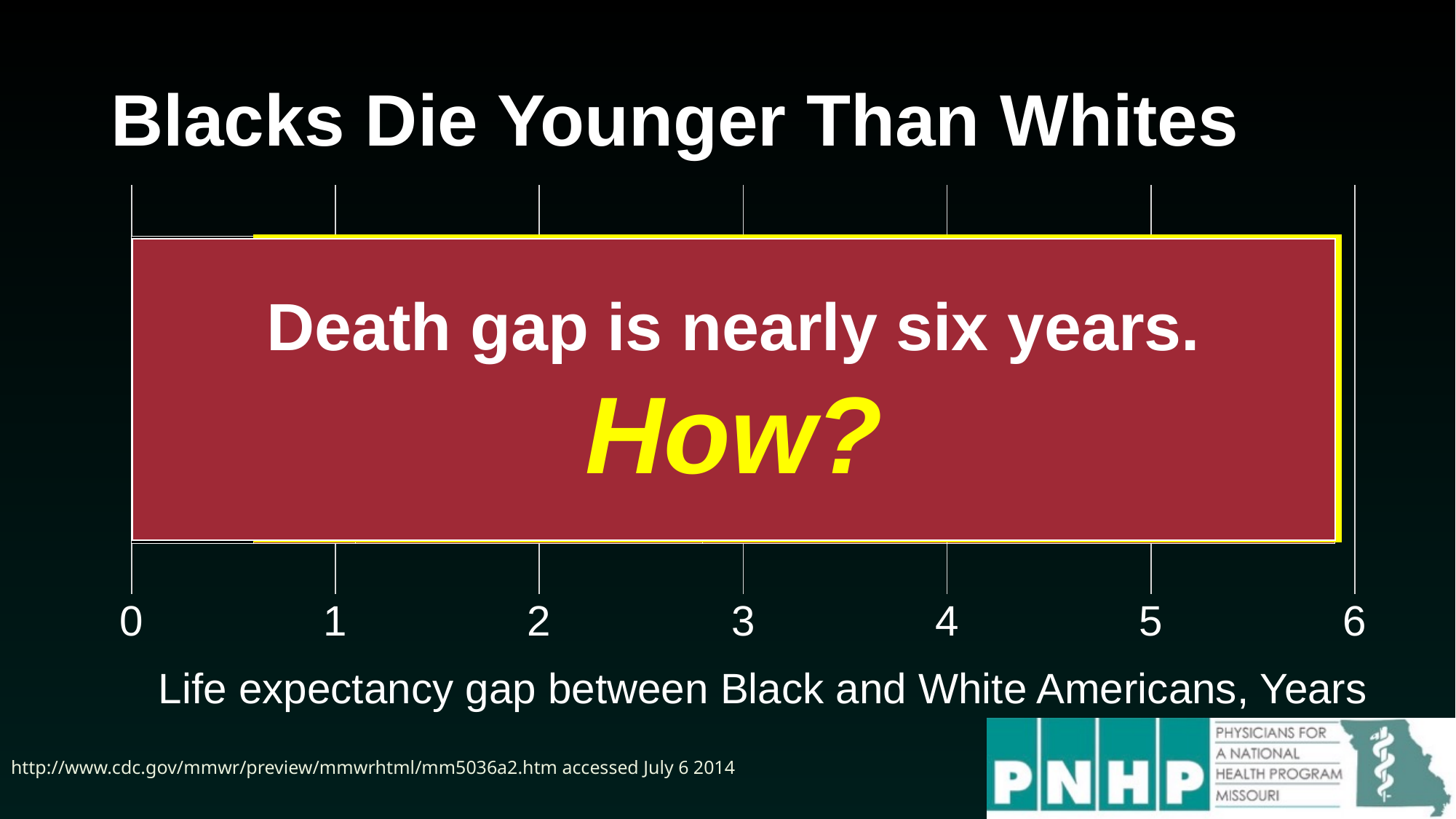
Is the value of the bar greater or less than 5? greater What is the highest value labelled on the x axis? 6 Is the value of the bar greater or less than 3? greater Is the value of the bar greater or less than 6? less How many bars are plotted in the chart? 1 How many tick labels are shown on the x axis? 7 What is the title of the chart? Blacks Die Younger Than Whites What kind of chart is shown on the slide? bar chart